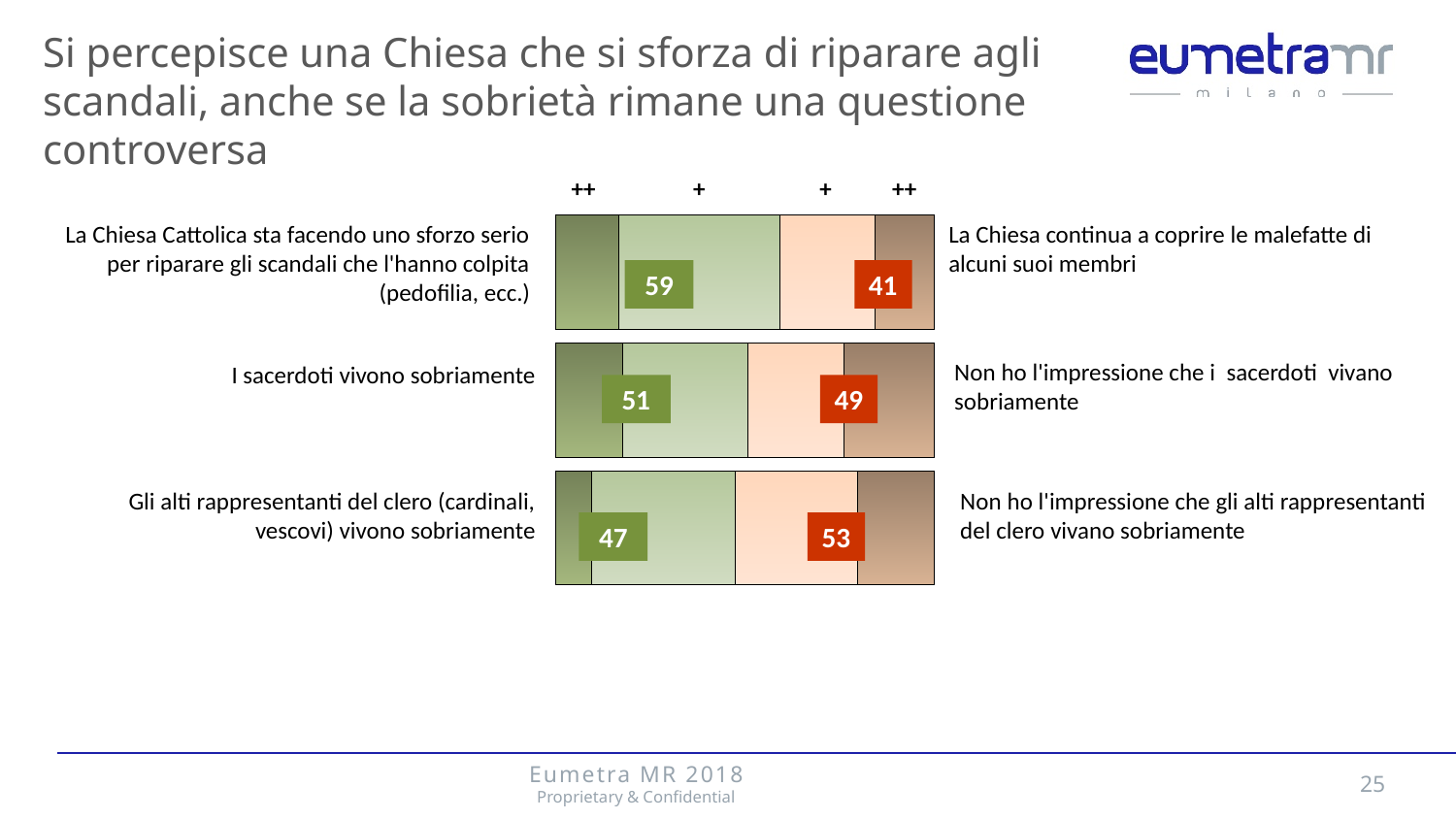
What is the green (agreement) value shown for the statement "La Chiesa Cattolica sta facendo uno sforzo serio per riparare gli scandali che l'hanno colpita (pedofilia, ecc.)"? 59 What is the orange (disagreement) value shown for the statement "La Chiesa continua a coprire le malefatte di alcuni suoi membri"? 41 What is the green value shown for the statement "I sacerdoti vivono sobriamente"? 51 In the bar for "I sacerdoti vivono sobriamente", which is larger: the green value or the orange value? The green value (51) What kind of chart is shown on the slide? Stacked bar chart Which statement has the highest green (agreement) value? La Chiesa Cattolica sta facendo uno sforzo serio per riparare gli scandali che l'hanno colpita (pedofilia, ecc.) How many statements (bars) are shown in the chart? 3 Which statement has the lowest green (agreement) value? Gli alti rappresentanti del clero (cardinali, vescovi) vivono sobriamente What is the difference between the green value (59) and the orange value (41) in the first bar? 18 What is the total of the green and orange values in the first bar (59 and 41)? 100 What is the difference between the orange value (53) and the green value (47) in the third bar? 6 What is the orange value shown for the statement "Non ho l'impressione che gli alti rappresentanti del clero vivano sobriamente"? 53